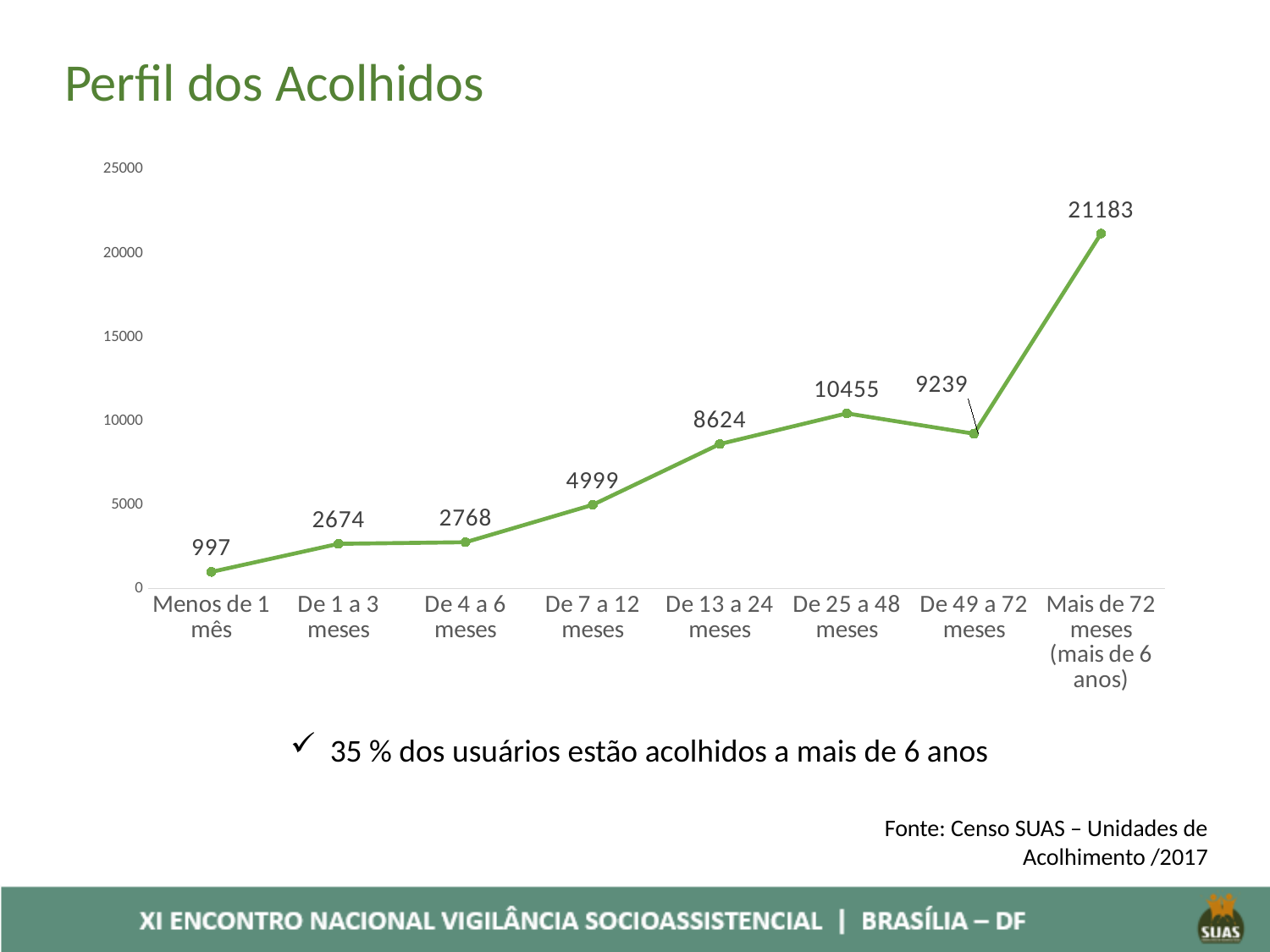
How many categories are plotted on the x axis? 8 What is the value for "Menos de 1 mês"? 997 What kind of chart is shown on the slide? line chart Which category has the lowest value? Menos de 1 mês What is the difference between the values for "De 25 a 48 meses" and "De 49 a 72 meses"? 1216 Which category has the highest value? Mais de 72 meses (mais de 6 anos) Do the values rise or fall from "De 25 a 48 meses" to "De 49 a 72 meses"? fall What is the title of the slide containing the chart? Perfil dos Acolhidos What is the value for "De 7 a 12 meses"? 4999 What is the value for "Mais de 72 meses (mais de 6 anos)"? 21183 Is the value for "De 25 a 48 meses" greater or less than 10000? greater Which is larger, the value for "De 13 a 24 meses" or the value for "De 49 a 72 meses"? De 49 a 72 meses